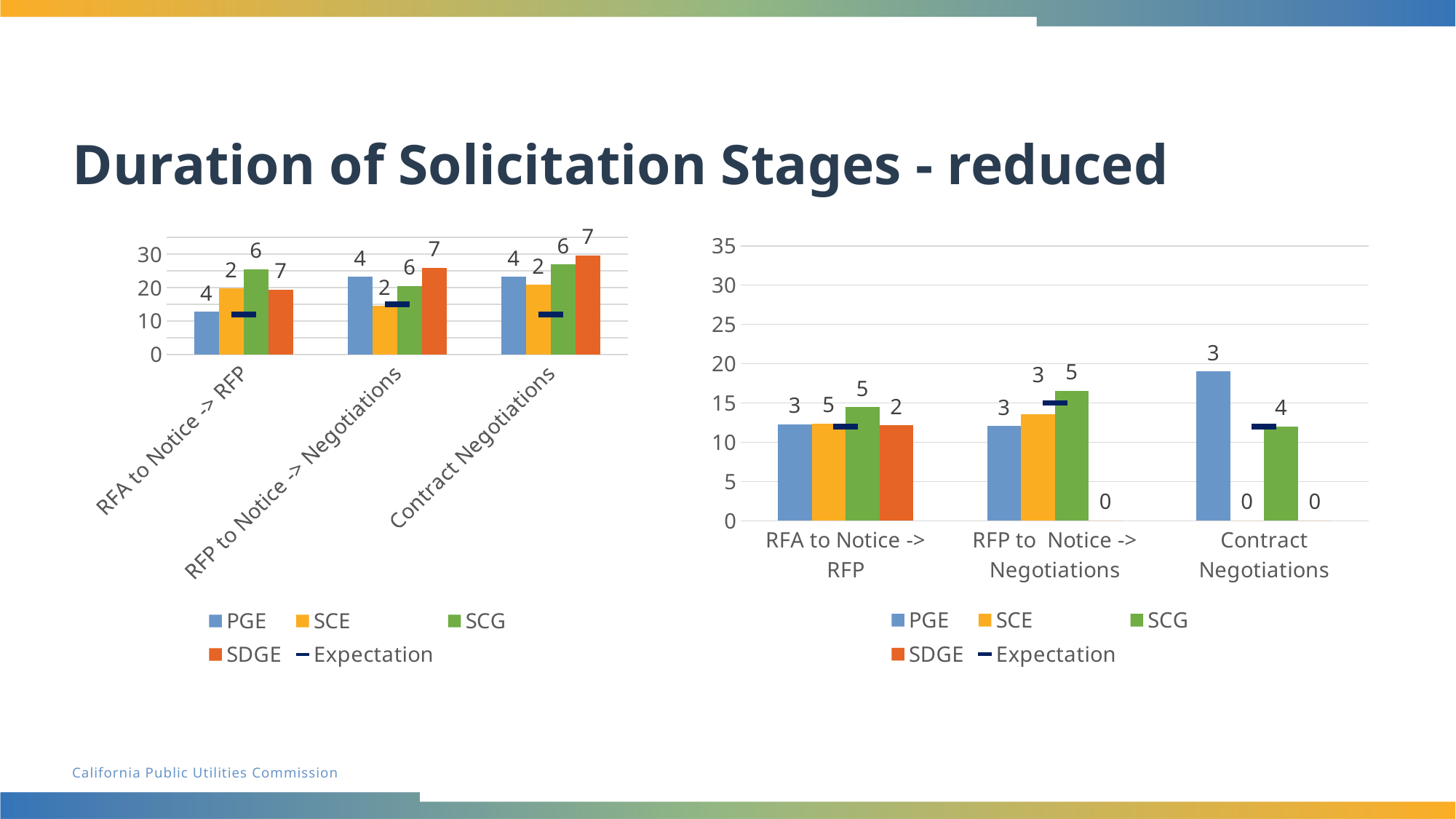
What kind of chart is the left chart on the slide? bar chart In the left chart, which series has the tallest bar for RFA to Notice -> RFP? SCG In the right chart, which series has the tallest bar for RFP to Notice -> Negotiations? SCG In the left chart, for Contract Negotiations, which bar is taller: SDGE or PGE? SDGE How many categories are shown on the x axis of the left chart? 3 How many entries does the legend of the right chart list? 5 What is the title of the slide? Duration of Solicitation Stages - reduced In the right chart, what value is labelled for SDGE under Contract Negotiations? 0 In the left chart, is the SDGE bar for Contract Negotiations greater or less than 20? greater In the right chart, is the PGE bar for Contract Negotiations greater or less than 15? greater In the right chart, for RFA to Notice -> RFP, which bar is taller: SCG or SDGE? SCG In the left chart, is the PGE bar for RFA to Notice -> RFP greater or less than 20? less